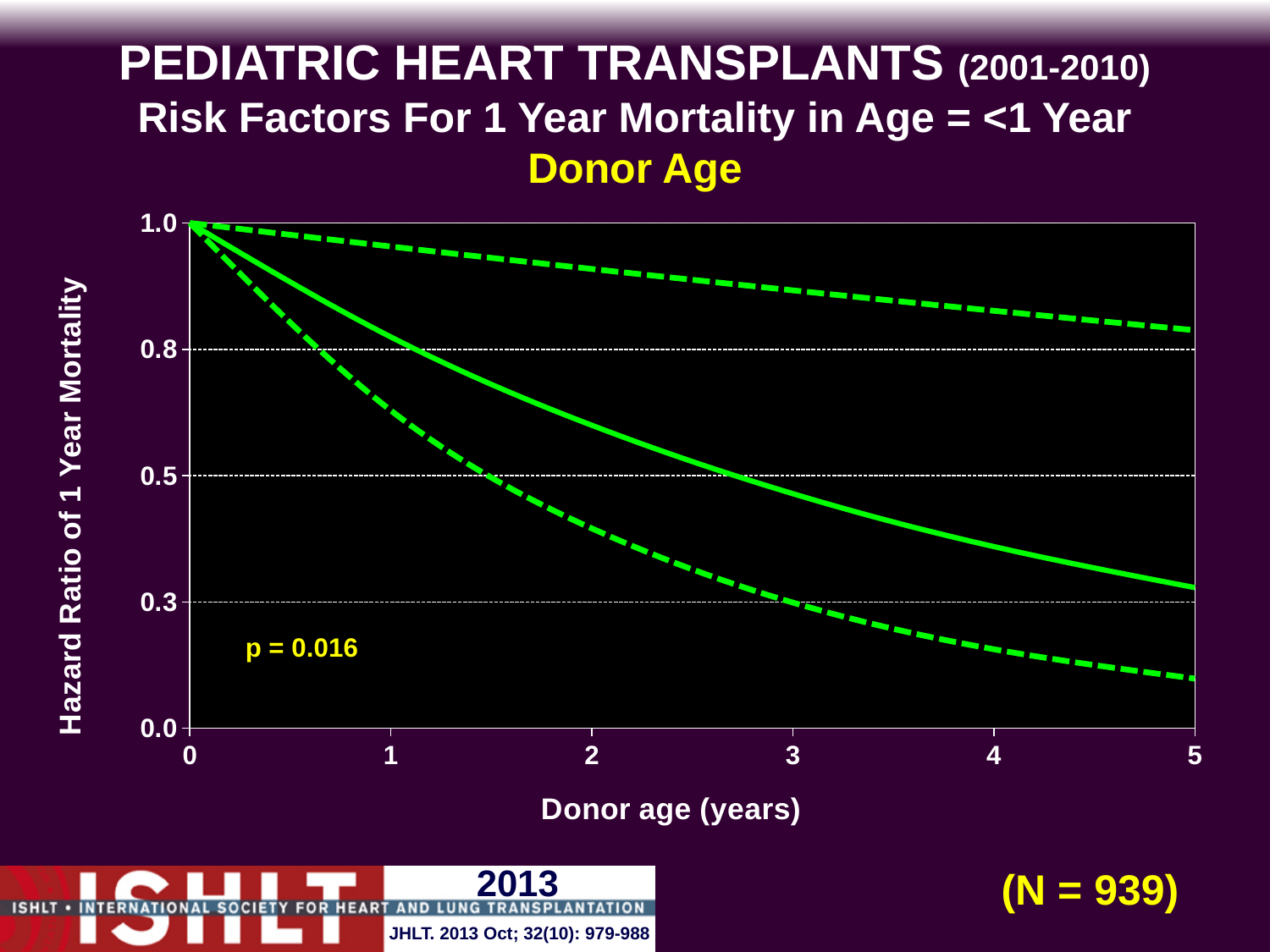
What is the label of the x axis? Donor age (years) What p-value is printed on the chart? p = 0.016 Does the solid line rise or fall as donor age increases from 0 to 5 years? fall At donor age 5 years, which line has the higher value: the solid line or the lower dashed line? the solid line What is the hazard ratio of 1 year mortality for the solid line at donor age 0 years? 1.0 Is the value of the lower dashed line at donor age 1 year greater or less than 0.8? less How many lines are plotted on the chart? 3 Is the value of the solid line at donor age 4 years greater or less than 0.5? less What kind of chart is shown on the slide? line chart What is the highest donor age shown on the x axis? 5 Is the value of the lower dashed line at donor age 2 years greater or less than 0.5? less